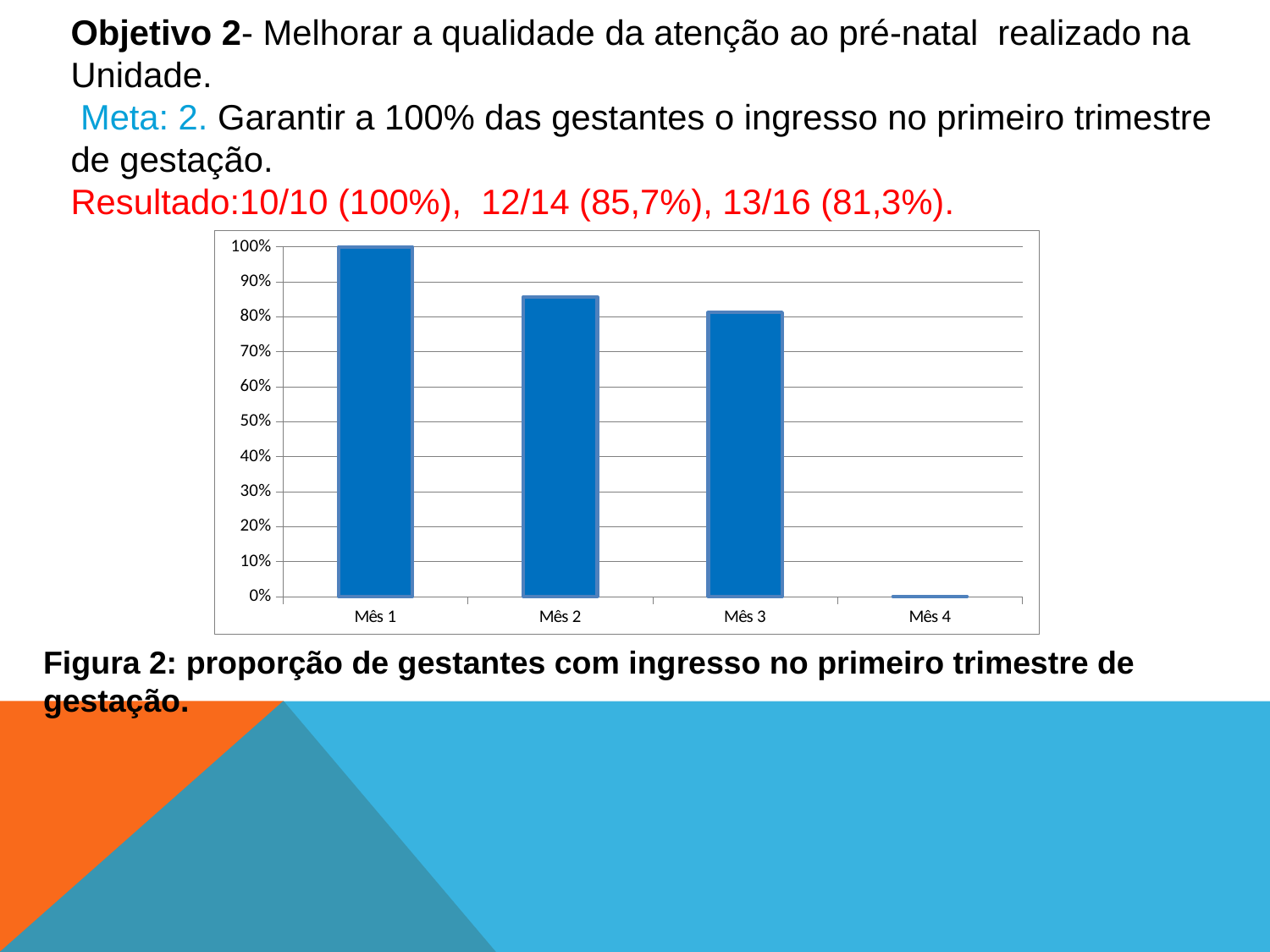
According to the slide, what is the proportion for Mês 3? 81,3% Is the value for Mês 2 greater or less than 80%? greater What is the caption given for the figure below the chart? Figura 2: proporção de gestantes com ingresso no primeiro trimestre de gestação. What is the value for Mês 1 in the chart? 100% Do the values rise or fall from Mês 1 to Mês 4? fall Which month has the lowest bar in the chart? Mês 4 Which is larger, the value for Mês 2 or the value for Mês 3? Mês 2 What type of chart is shown on the slide? bar chart Is the value for Mês 4 greater or less than 10%? less According to the slide, what is the proportion for Mês 2? 85,7% Which month has the highest bar in the chart? Mês 1 How many categories (months) are shown on the x axis of the chart? 4